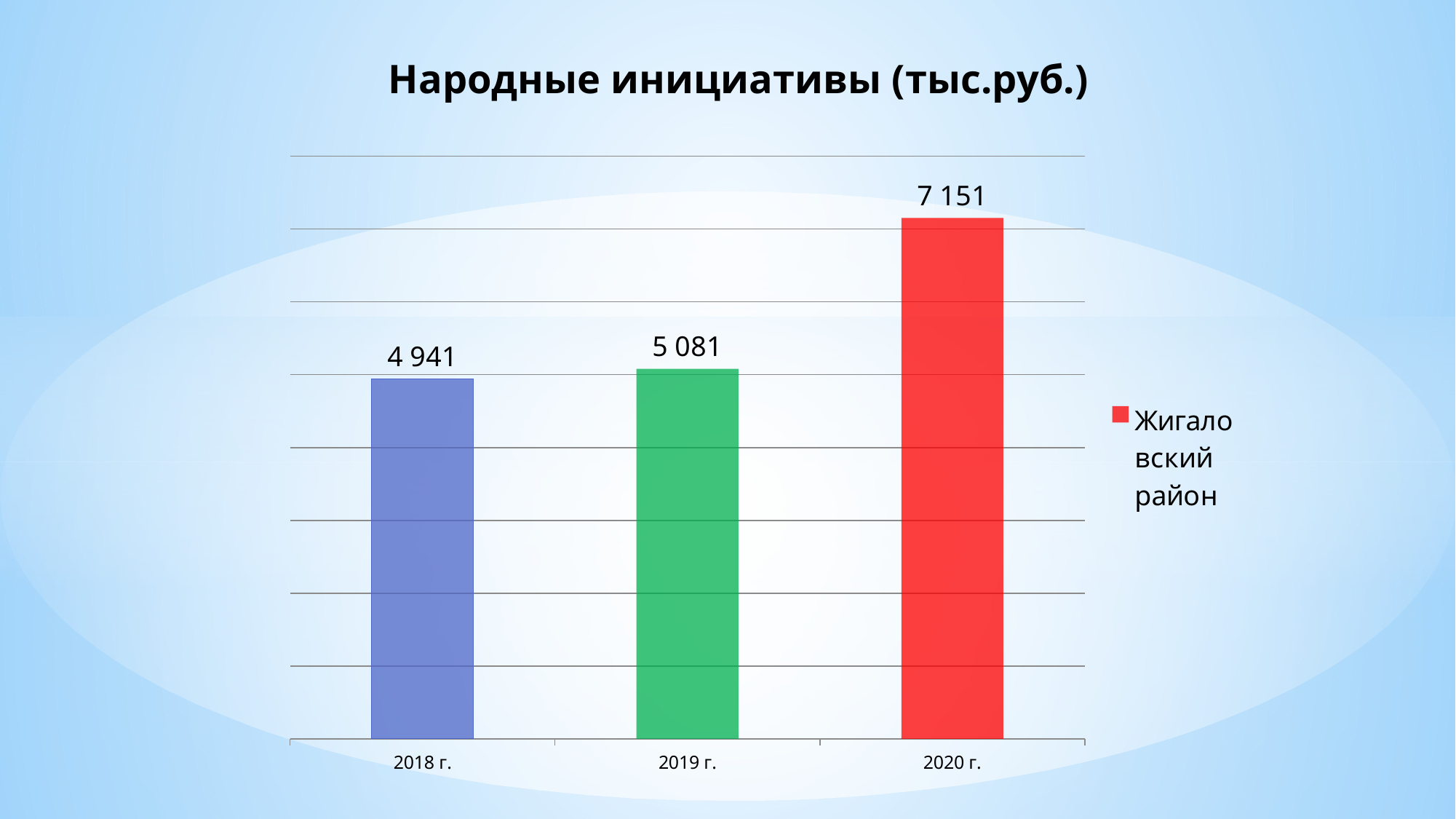
What kind of chart is shown? bar chart What is the value for 2019 г.? 5 081 Which year has the lowest value? 2018 г. How many years are shown on the x axis? 3 What is the difference between the values for 2020 г. and 2018 г.? 2 210 How many series does the legend list? 1 What is the value for 2018 г.? 4 941 What is the difference between the values for 2019 г. and 2018 г.? 140 Do the values rise or fall from 2018 г. to 2020 г.? rise What is the value for 2020 г.? 7 151 Which is larger, the value for 2019 г. or the value for 2020 г.? 2020 г. Which year has the highest value? 2020 г.